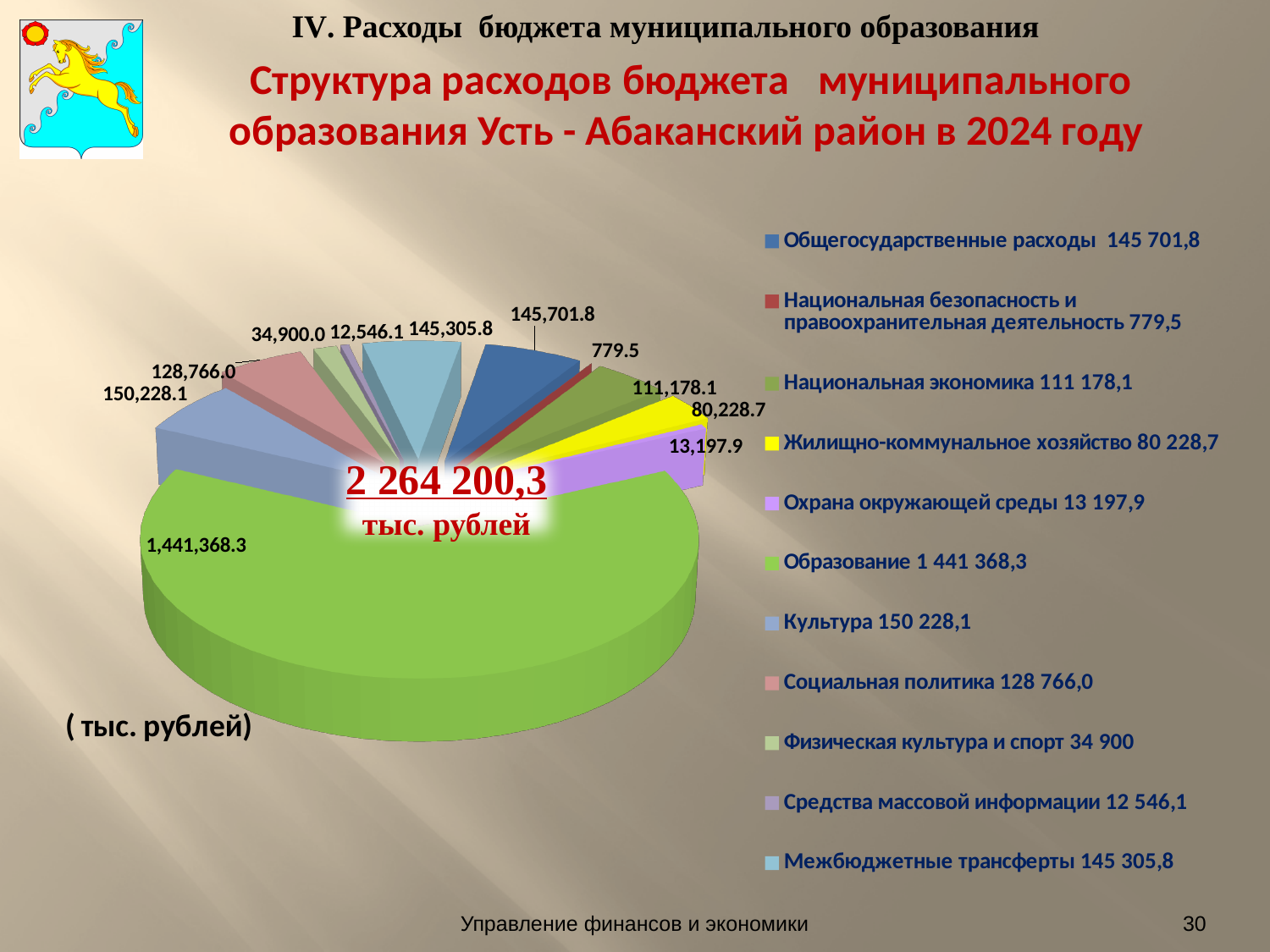
What is the value for Общегосударственные расходы? 145,701.8 How many categories does the pie chart have? 11 What is the value for Образование in the pie chart? 1,441,368.3 What colour is the slice for Жилищно-коммунальное хозяйство? Yellow Which is larger: Социальная политика or Национальная экономика? Социальная политика Which category has the largest slice of the pie? Образование What is the difference between the values for Культура and Межбюджетные трансферты? 4,922.3 What is the value for Национальная безопасность и правоохранительная деятельность? 779.5 Which category has the smallest slice of the pie? Национальная безопасность и правоохранительная деятельность What total is shown in the centre of the pie chart? 2 264 200,3 тыс. рублей What is the value for Жилищно-коммунальное хозяйство? 80,228.7 What type of chart is shown on the slide? Pie chart